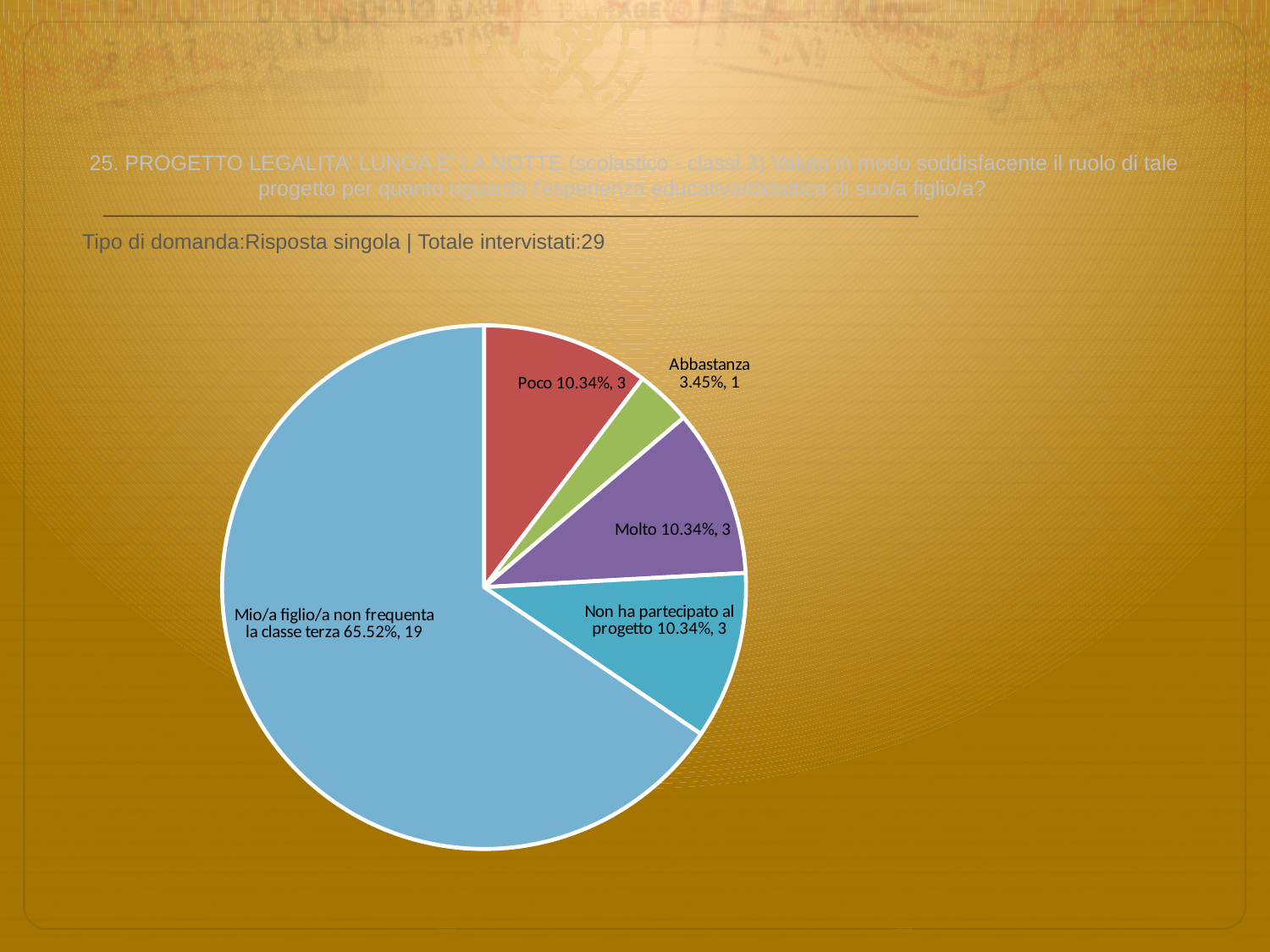
Which category has the smallest slice? Abbastanza How many respondents answered 'Abbastanza'? 1 What percentage share does the 'Molto' slice have? 10.34% How many slices does the pie chart have? 5 What is the total number of respondents stated on the slide? 29 How many respondents answered 'Non ha partecipato al progetto'? 3 Which has more respondents, 'Molto' or 'Abbastanza'? Molto How many respondents answered 'Poco'? 3 What is the difference in respondent count between 'Mio/a figlio/a non frequenta la classe terza' and 'Poco'? 16 What kind of chart is shown on the slide? pie chart What percentage share does the 'Mio/a figlio/a non frequenta la classe terza' slice have? 65.52% Which category has the largest slice? Mio/a figlio/a non frequenta la classe terza